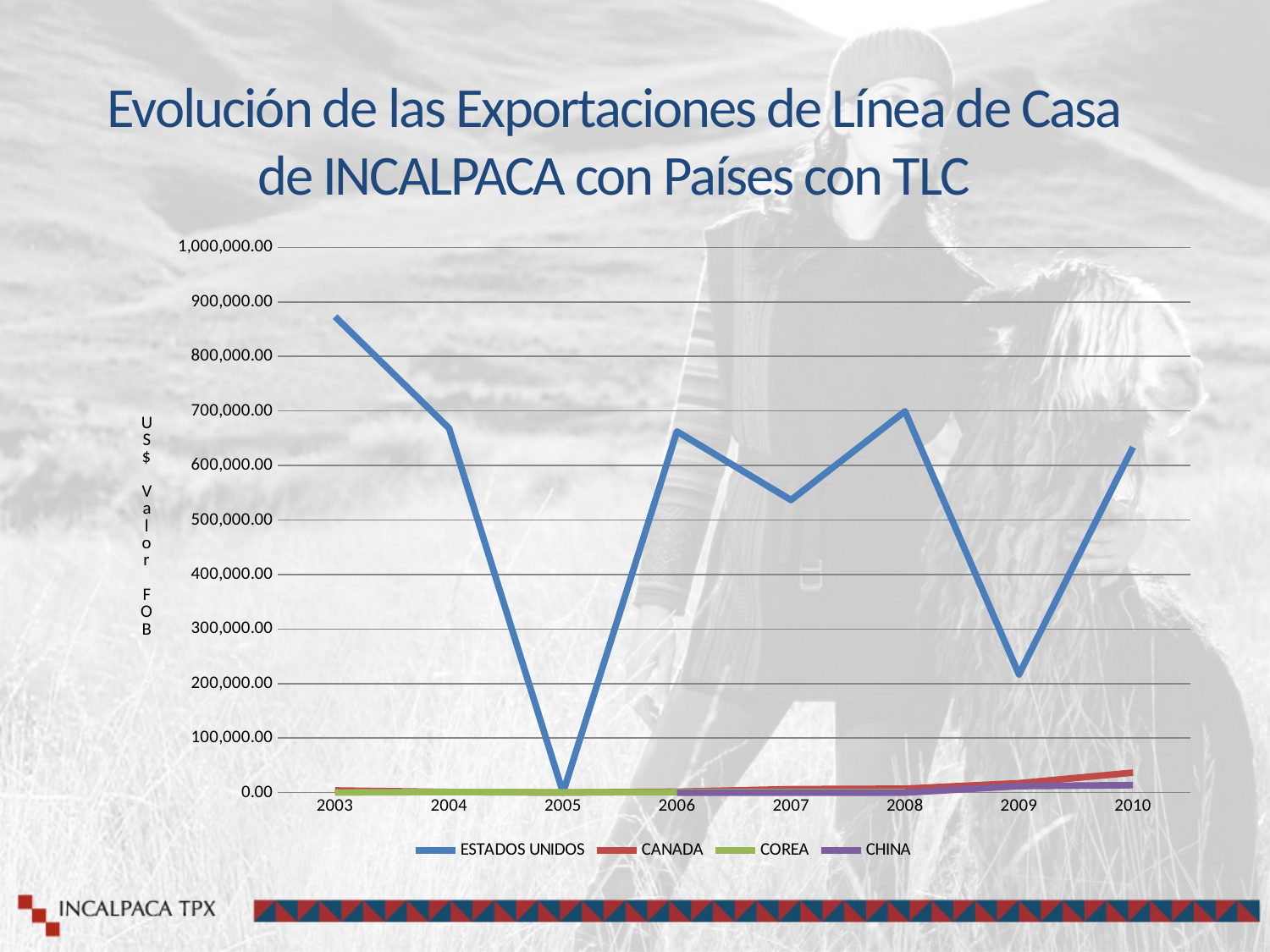
Does the ESTADOS UNIDOS series rise or fall from 2003 to 2005? fall Does the ESTADOS UNIDOS series rise or fall from 2009 to 2010? rise Which series is drawn in red in the legend? CANADA How many years are shown along the x axis? 8 Which is larger for ESTADOS UNIDOS: the value in 2008 or the value in 2009? 2008 Is the value for ESTADOS UNIDOS in 2003 greater or less than 800,000.00? greater Is the value for ESTADOS UNIDOS in 2007 greater or less than 500,000.00? greater What kind of chart is shown on the slide? line chart How many series does the legend list? 4 In which year does the ESTADOS UNIDOS series reach its lowest value? 2005 Is the value for ESTADOS UNIDOS in 2009 greater or less than 300,000.00? less In which year does the ESTADOS UNIDOS series reach its highest value? 2003